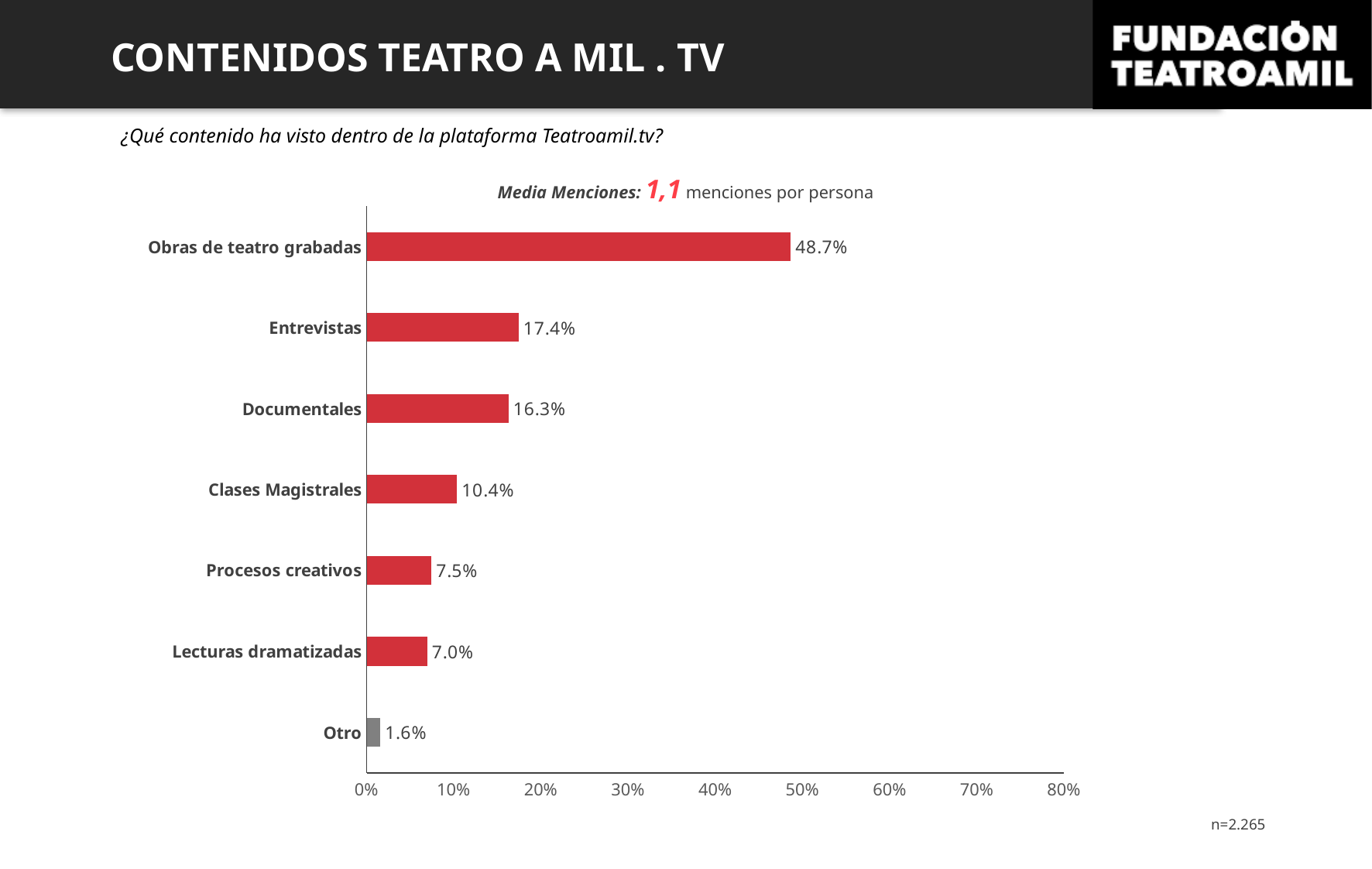
Which is larger, the value for Procesos creativos or the value for Clases Magistrales? Clases Magistrales Which category has the lowest value? Otro What is the value for Obras de teatro grabadas? 48.7% Which category has the highest value? Obras de teatro grabadas What is the Media Menciones value stated above the chart? 1,1 menciones por persona What is the difference between the values for Entrevistas and Documentales? 1.1% What is the value for Lecturas dramatizadas? 7.0% How many categories are shown in the chart? 7 What is the value for Documentales? 16.3% What is the difference between the values for Obras de teatro grabadas and Clases Magistrales? 38.3% Is the value for Obras de teatro grabadas greater or less than 40%? greater What kind of chart is shown on the slide? bar chart